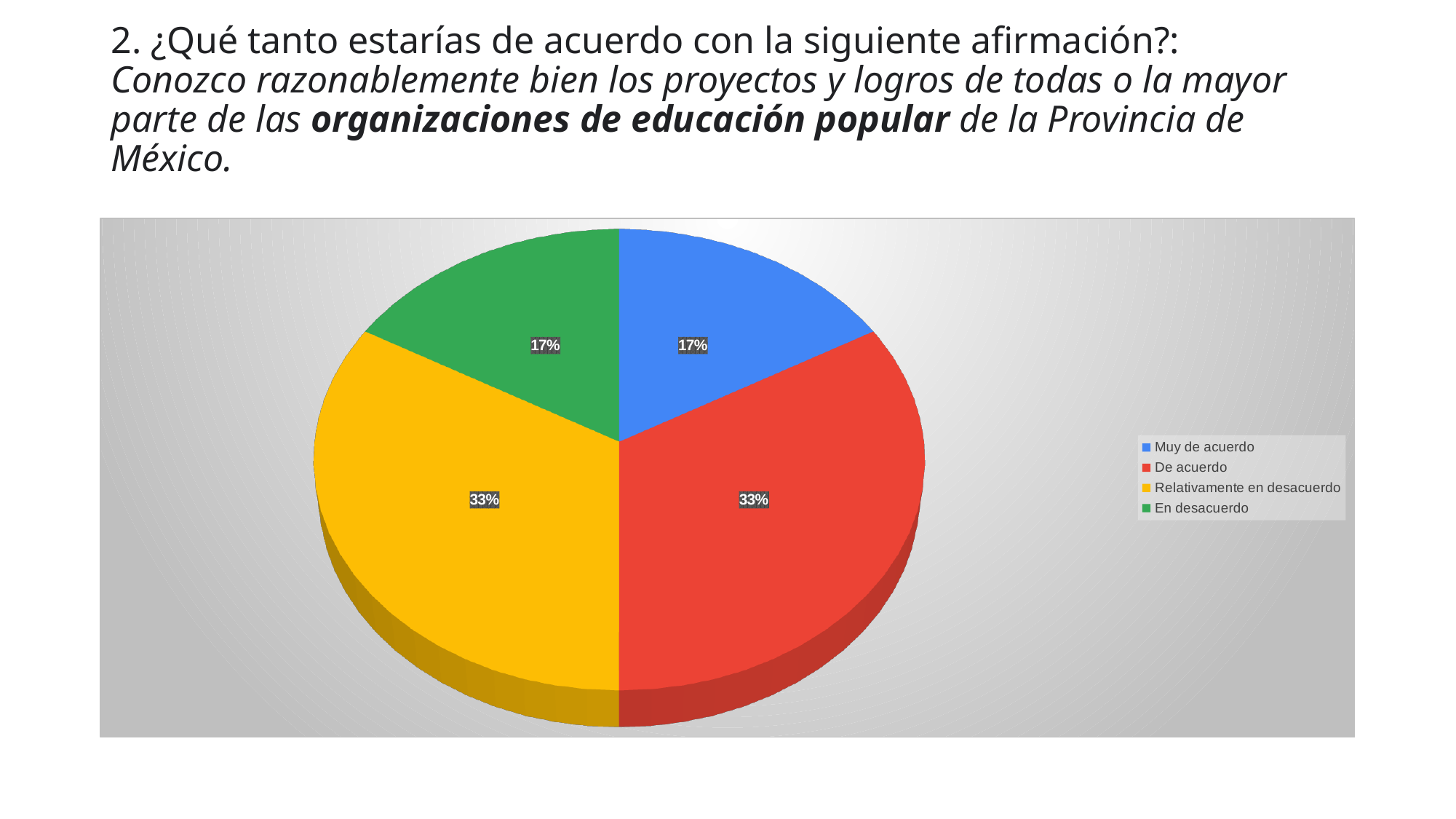
What colour is the "Relativamente en desacuerdo" slice? Yellow What is the combined share of "Muy de acuerdo" and "De acuerdo"? 50% What is the difference in percentage points between the "De acuerdo" slice and the "En desacuerdo" slice? 16 percentage points Which is larger, the share for "Relativamente en desacuerdo" or the share for "En desacuerdo"? Relativamente en desacuerdo What percentage of respondents answered "Relativamente en desacuerdo"? 33% What percentage of respondents answered "De acuerdo"? 33% What percentage of respondents answered "Muy de acuerdo"? 17% Which is larger, the share for "De acuerdo" or the share for "Muy de acuerdo"? De acuerdo Which legend entry is shown in green? En desacuerdo What kind of chart is shown on the slide? Pie chart How many categories does the pie chart show? 4 What percentage of respondents answered "En desacuerdo"? 17%